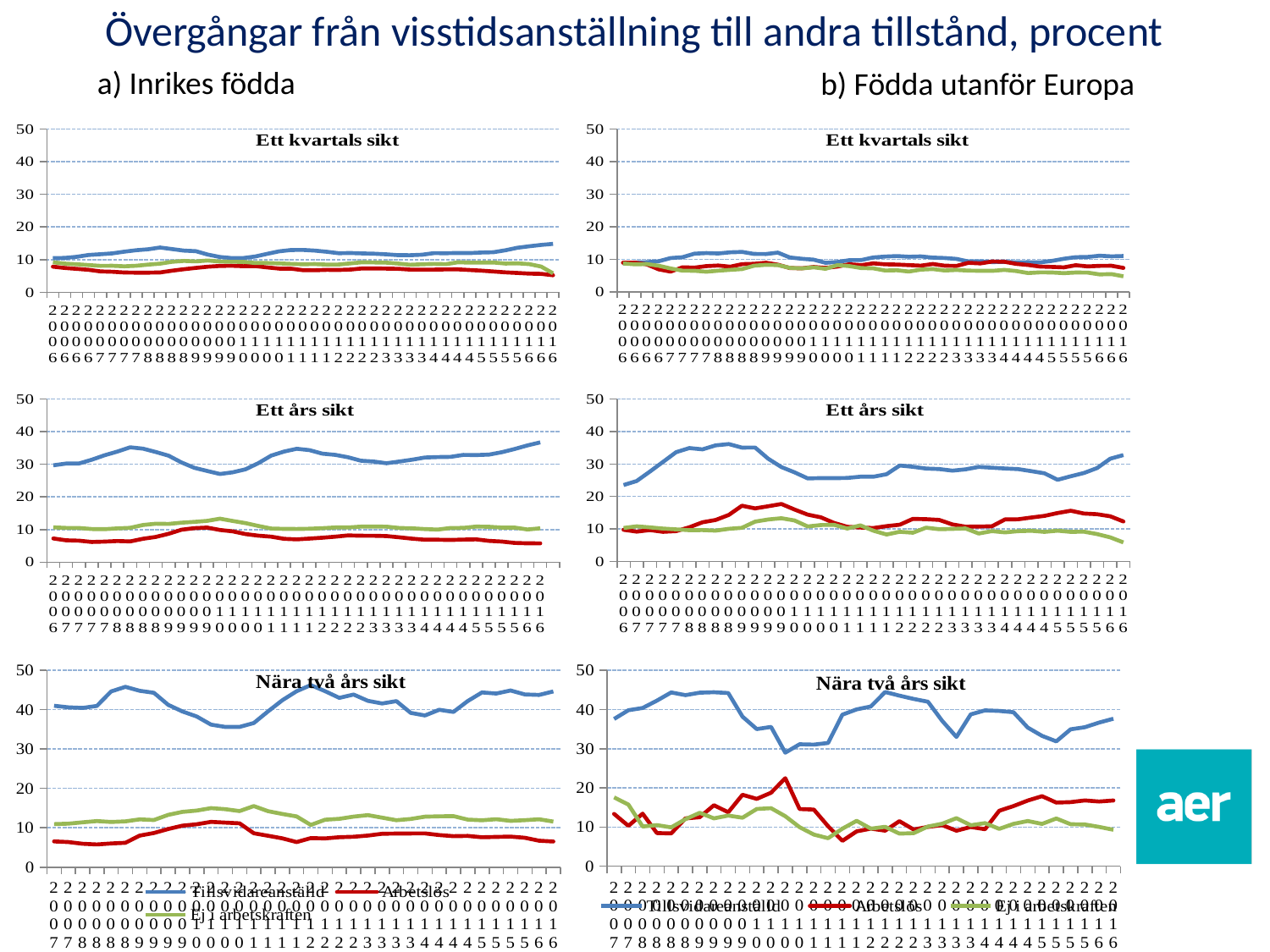
In the 'Ett års sikt' chart under b) Födda utanför Europa, is the highest value for Tillsvidareanställd greater or less than 30? greater In the 'Ett års sikt' chart under a) Inrikes födda, is the value for Tillsvidareanställd greater or less than 20 at every point? greater What are the titles of the three rows of charts, from top to bottom? Ett kvartals sikt, Ett års sikt, Nära två års sikt In the 'Nära två års sikt' chart under b) Födda utanför Europa, which is larger at the final point: Arbetslös or Ej i arbetskraften? Arbetslös How many charts are shown on the slide? 6 What is the title of the slide? Övergångar från visstidsanställning till andra tillstånd, procent What kind of chart is used for the 'Ett kvartals sikt' panel under a) Inrikes födda? line chart In the 'Ett års sikt' chart under a) Inrikes födda, which series has the highest values? Tillsvidareanställd How many series does the legend list for the charts on this slide? 3 In the 'Ett kvartals sikt' chart under b) Födda utanför Europa, are all three series greater or less than 20 throughout? less In the 'Ett kvartals sikt' chart under a) Inrikes födda, does the Tillsvidareanställd line end higher or lower than it starts? higher